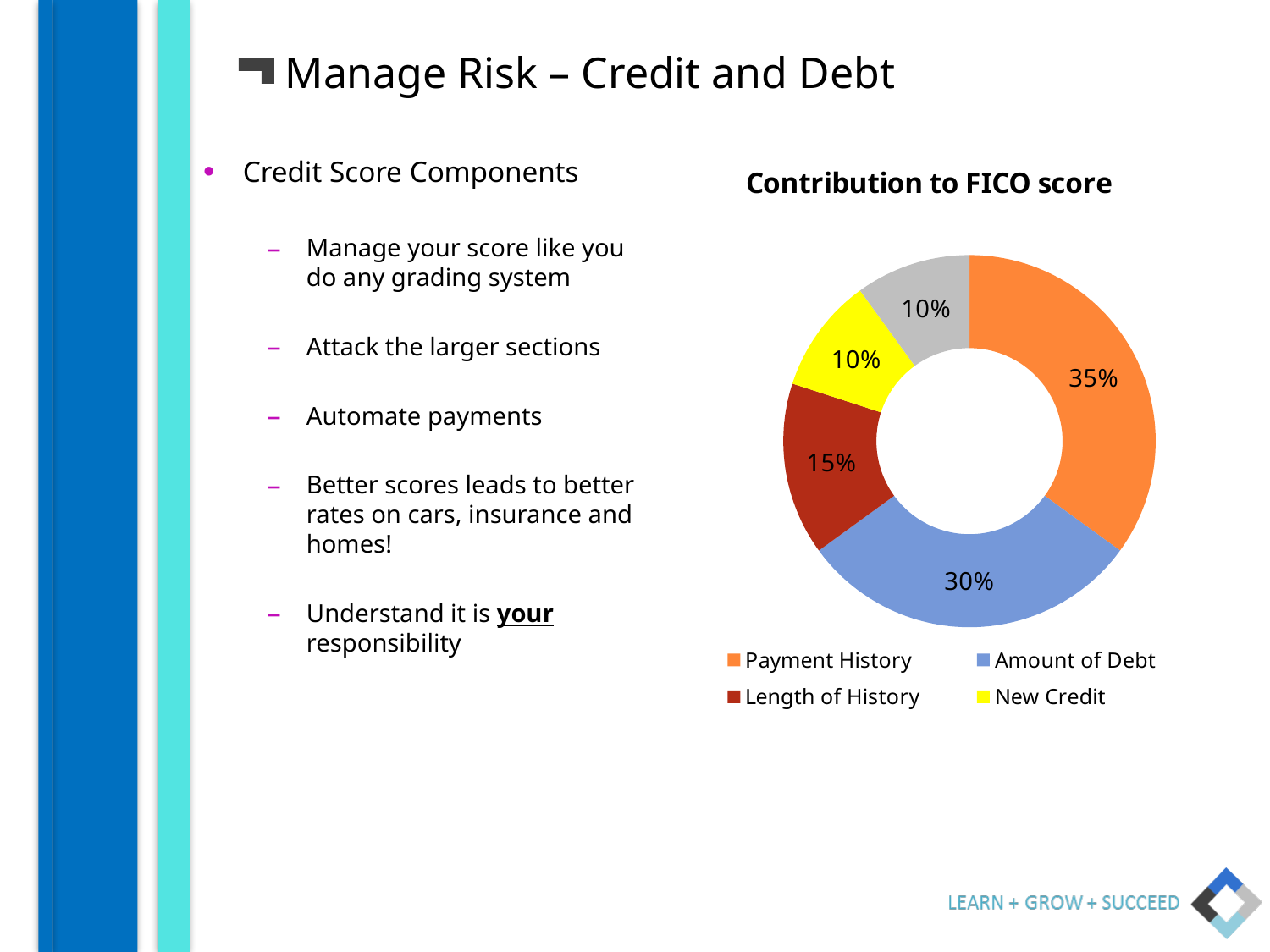
What is the difference between the Amount of Debt share and the Length of History share? 15% How many slices does the Contribution to FICO score chart have? 5 Which component has the largest share in the Contribution to FICO score chart? Payment History What is the value for New Credit in the Contribution to FICO score chart? 10% What is the value for Length of History in the Contribution to FICO score chart? 15% How many entries does the legend of the Contribution to FICO score chart list? 4 What kind of chart is shown on the slide? Doughnut (pie) chart Which is larger, the share for Length of History or the share for New Credit? Length of History What is the value for Payment History in the Contribution to FICO score chart? 35% What colour represents Payment History in the chart? Orange How much larger is the Payment History share than the Amount of Debt share? 5% What is the value for Amount of Debt in the Contribution to FICO score chart? 30%